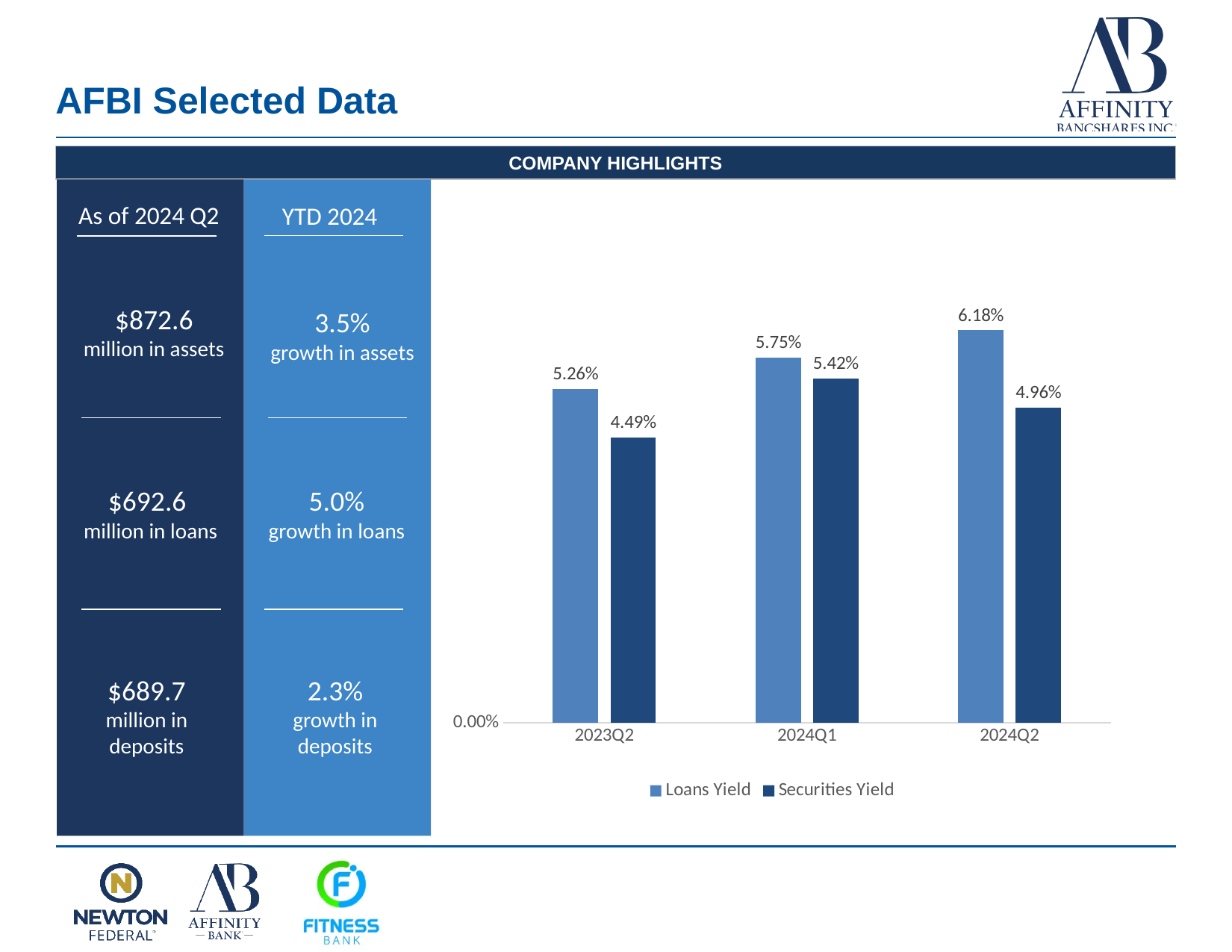
Which period has the lowest Securities Yield? 2023Q2 What is the Securities Yield for 2024Q1? 5.42% Which is larger in 2024Q1, the Loans Yield or the Securities Yield? Loans Yield What is the Securities Yield for 2023Q2? 4.49% Which period has the highest Loans Yield? 2024Q2 How many periods are shown on the x axis of the chart? 3 What is the Loans Yield for 2023Q2? 5.26% What is the difference between the Loans Yield and the Securities Yield in 2024Q2? 1.22% How many series does the chart legend list? 2 Does the Loans Yield rise or fall from 2023Q2 to 2024Q2? Rise What is the Loans Yield for 2024Q2? 6.18% What kind of chart is shown on the slide? Bar chart